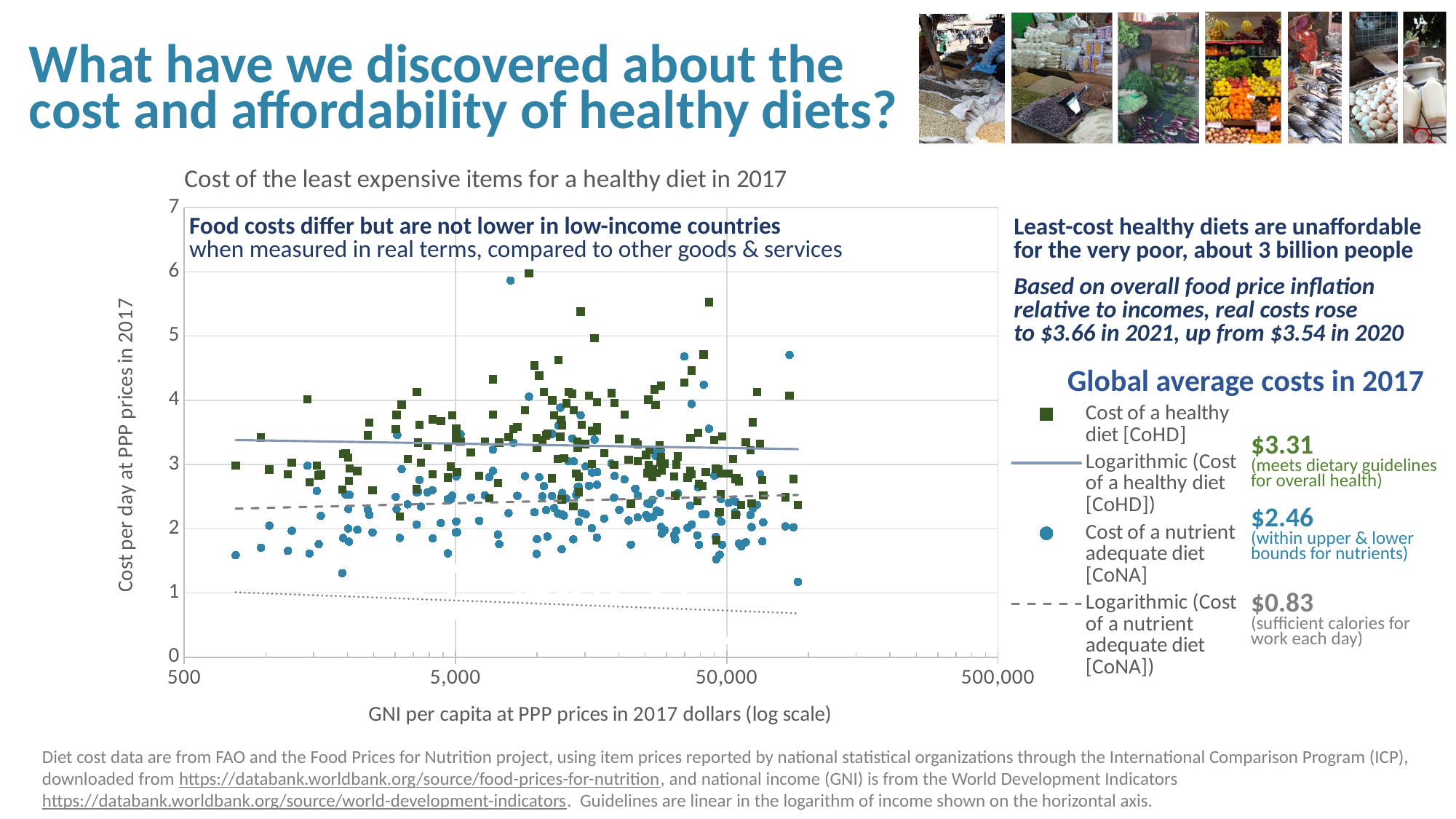
Does the logarithmic trend line for the cost of a healthy diet [CoHD] rise or fall as GNI per capita increases? Fall What is the global average cost in 2017 of a healthy diet [CoHD] shown next to the legend? $3.31 What is the label of the horizontal axis? GNI per capita at PPP prices in 2017 dollars (log scale) How many entries does the chart's legend list? 4 What kind of chart is shown on the slide? Scatter chart What is the global average cost in 2017 for sufficient calories for work each day? $0.83 Which of the three global average costs in 2017 is the lowest? $0.83 (sufficient calories for work each day) What is the global average cost in 2017 of a nutrient adequate diet [CoNA] shown next to the legend? $2.46 What is the difference between the global average cost of a healthy diet ($3.31) and of a nutrient adequate diet ($2.46) in 2017? $0.85 What is the title of the chart? Cost of the least expensive items for a healthy diet in 2017 Which global average cost in 2017 is higher: the cost of a healthy diet or the cost of a nutrient adequate diet? Cost of a healthy diet Is the logarithmic trend line for the cost of a nutrient adequate diet [CoNA] greater or less than 3 across the chart? less